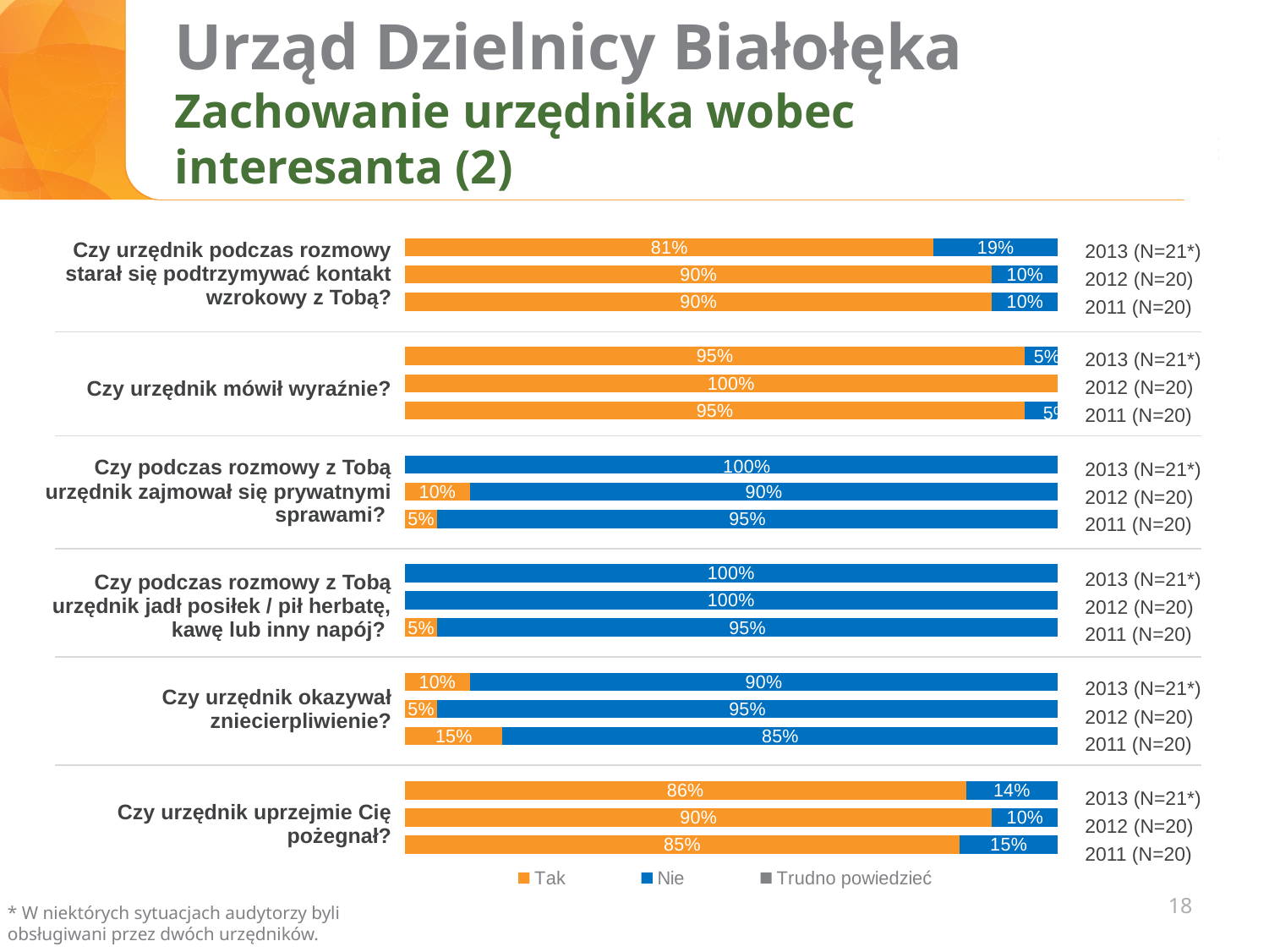
What percentage answered "Nie" in 2013 for "Czy urzędnik uprzejmie Cię pożegnał?"? 14% For "Czy urzędnik podczas rozmowy starał się podtrzymywać kontakt wzrokowy z Tobą?", by how many percentage points did the "Tak" share in 2012 exceed that in 2013? 9 percentage points Which colour represents "Tak" in the legend? Orange How many series does the legend list? 3 How many survey questions are shown on the chart? 6 What kind of chart is shown on the slide? Stacked bar chart What percentage answered "Tak" in 2011 for "Czy urzędnik okazywał zniecierpliwienie?"? 15% What percentage answered "Nie" in 2012 for "Czy podczas rozmowy z Tobą urzędnik zajmował się prywatnymi sprawami?"? 90% What percentage answered "Tak" in 2012 for "Czy urzędnik mówił wyraźnie?"? 100% For "Czy urzędnik okazywał zniecierpliwienie?", which year had the highest "Tak" share? 2011 What percentage answered "Tak" in 2013 for "Czy urzędnik podczas rozmowy starał się podtrzymywać kontakt wzrokowy z Tobą?"? 81% For "Czy urzędnik uprzejmie Cię pożegnał?", which year had the larger "Tak" share, 2012 or 2011? 2012